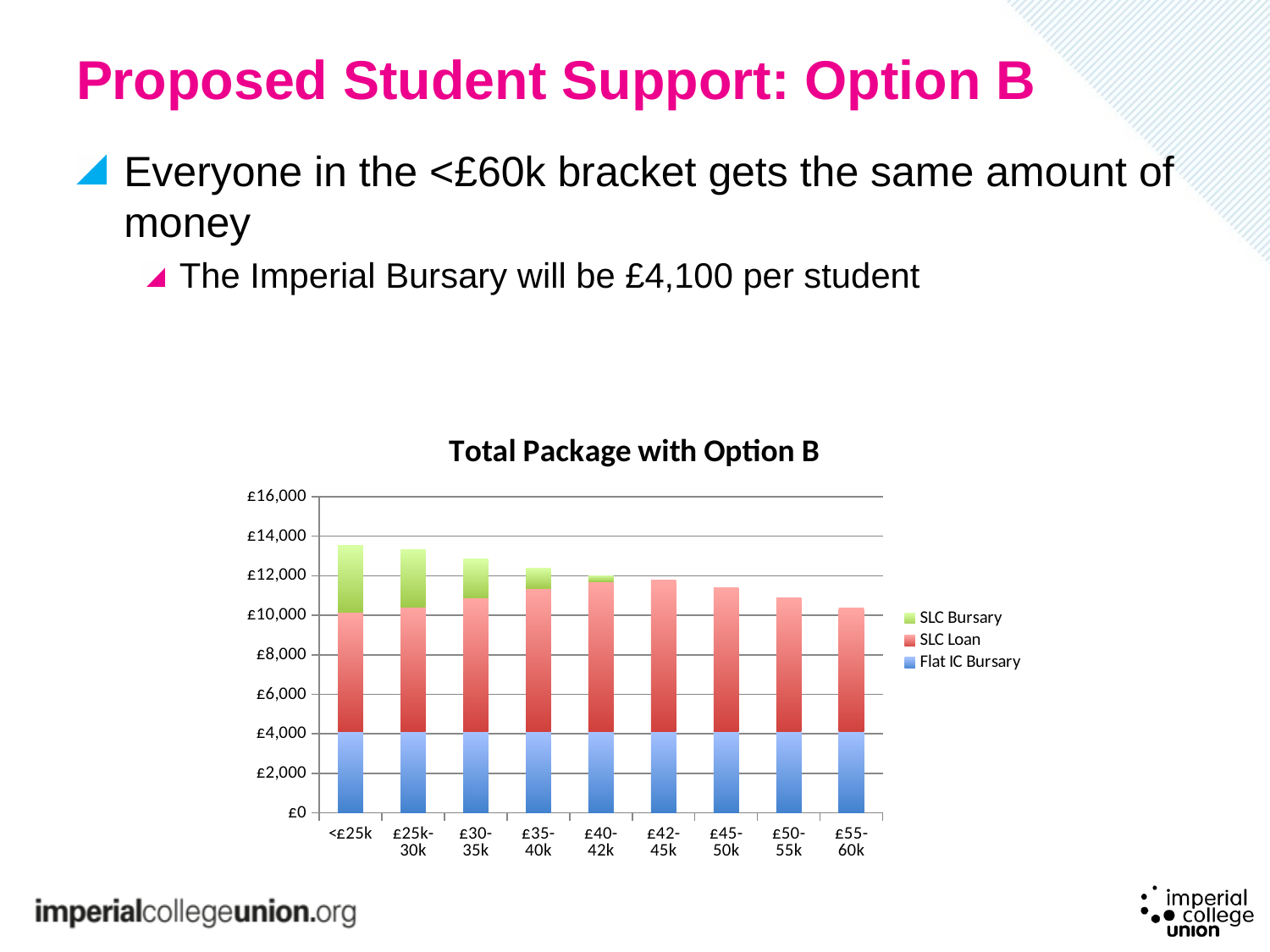
Which has the larger total package: the <£25k bracket or the £50-55k bracket? <£25k What is the title of the chart? Total Package with Option B Is the total package for the £55-60k bracket greater or less than £12,000? less How many income bracket categories are shown on the x axis of the chart? 9 Is the total package for the <£25k bracket greater or less than £12,000? greater How many series does the chart's legend list? 3 Which series is shown in green in the chart? SLC Bursary What kind of chart is shown on the slide? Stacked bar chart Do the total package values rise or fall as income brackets increase along the x axis? Fall Which income bracket has the lowest total package in the chart? £55-60k Is the total package for the £45-50k bracket greater or less than £12,000? less Which income bracket has the highest total package in the chart? <£25k